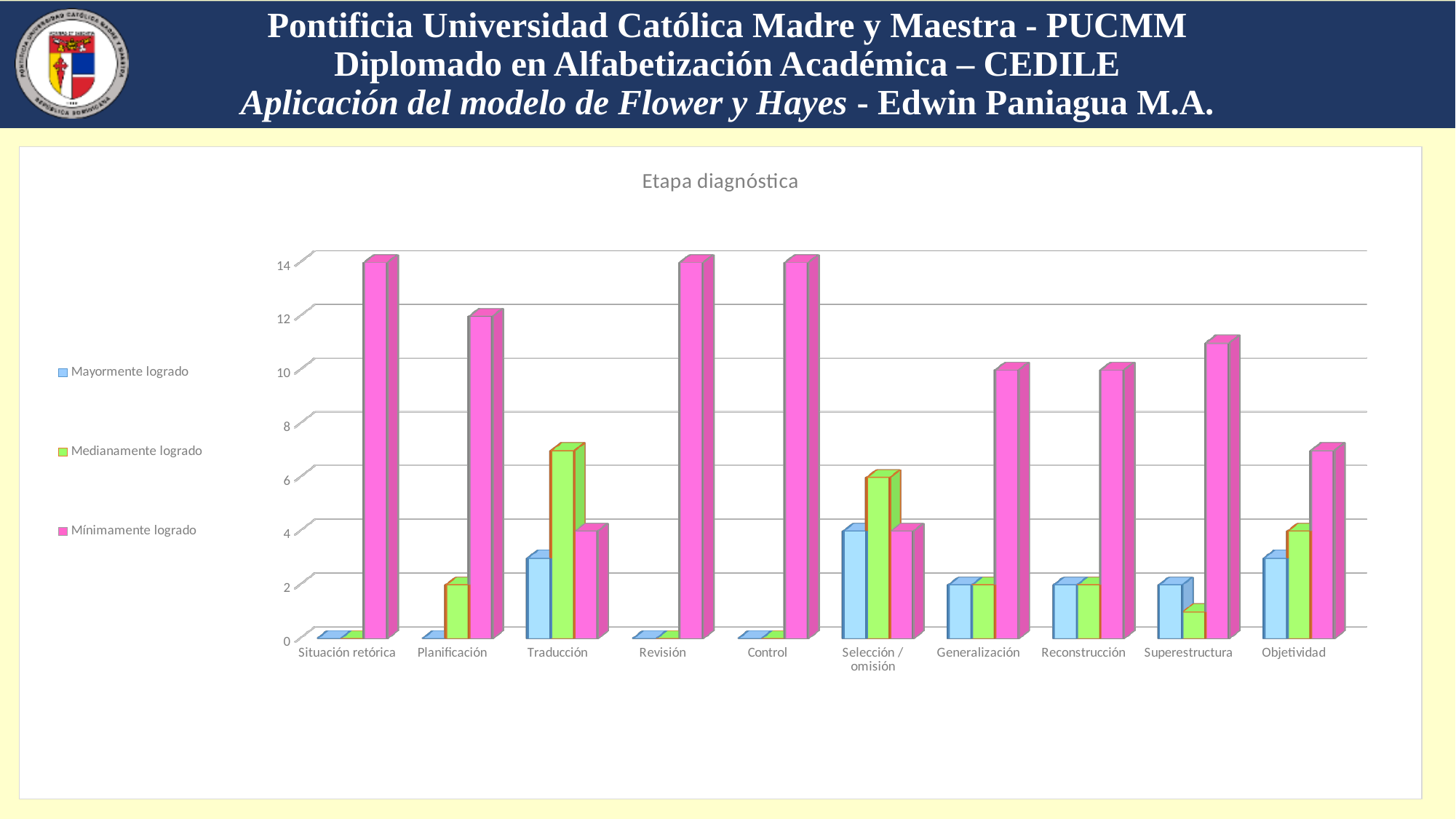
What is the value of Mínimamente logrado for Generalización? 10 How many categories are shown on the x axis? 10 What is the value of Mínimamente logrado for Situación retórica? 14 What is the value of Mínimamente logrado for Planificación? 12 Which series is shown in pink? Mínimamente logrado Is the value of Medianamente logrado for Traducción greater or less than 6? greater Is the value of Mínimamente logrado for Superestructura greater or less than 10? greater Which category has the lowest Mínimamente logrado value? Traducción and Selección / omisión Which is larger for Selección / omisión: Medianamente logrado or Mayormente logrado? Medianamente logrado How many series does the legend list? 3 What is the title of the chart? Etapa diagnóstica What kind of chart is shown on the slide? bar chart